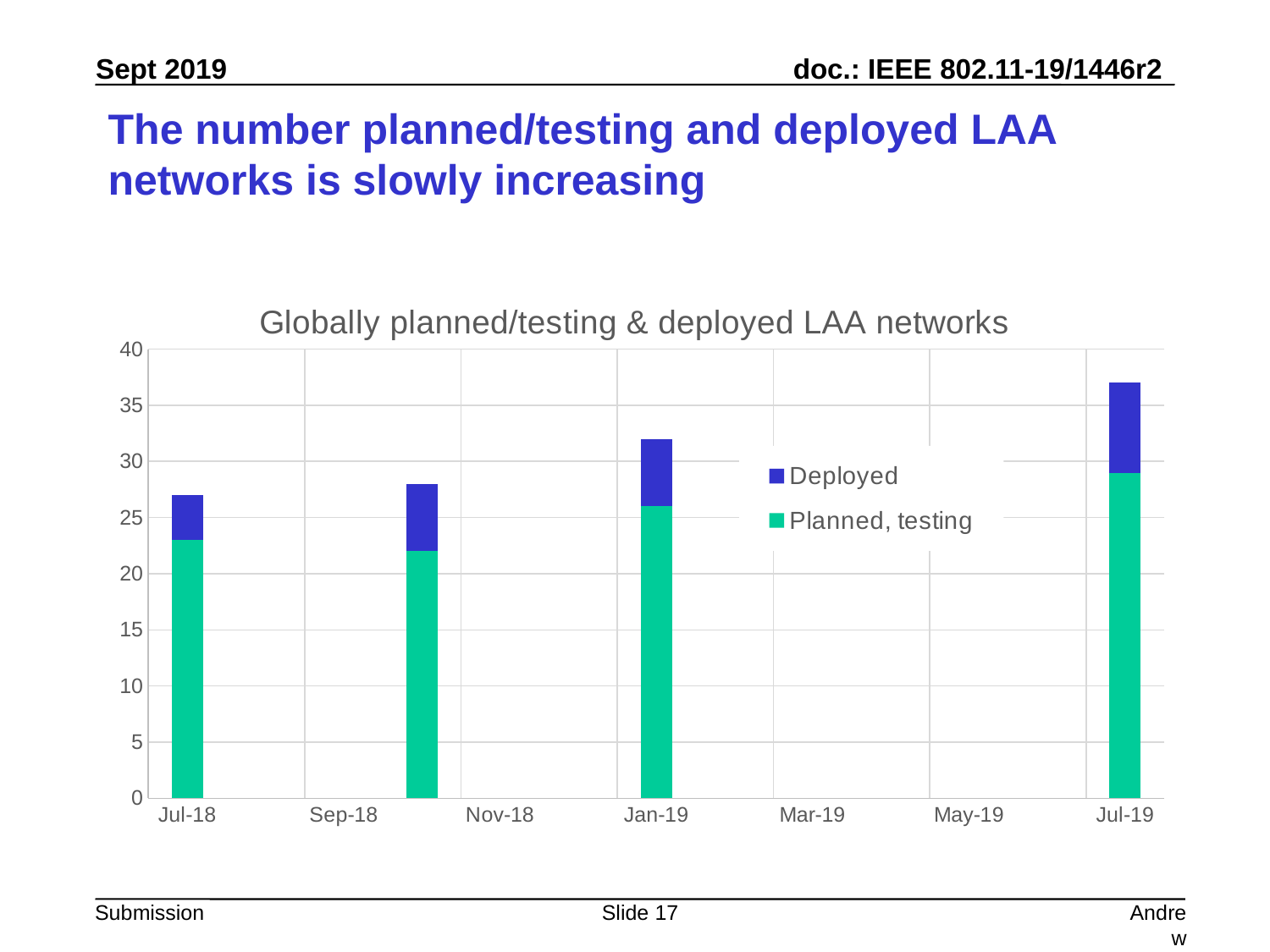
Is the total bar for Jul-19 greater or less than 35? greater Which date has the tallest total bar? Jul-19 Is the total bar for Jul-18 greater or less than 25? greater Is the total bar for Jan-19 greater or less than 30? greater Which series is shown in green? Planned, testing How many series does the legend list? 2 What is the title of the chart? Globally planned/testing & deployed LAA networks What kind of chart is shown on the slide? stacked bar chart How many bars are plotted in the chart? 4 Do the total bar heights rise or fall from Jul-18 to Jul-19? rise